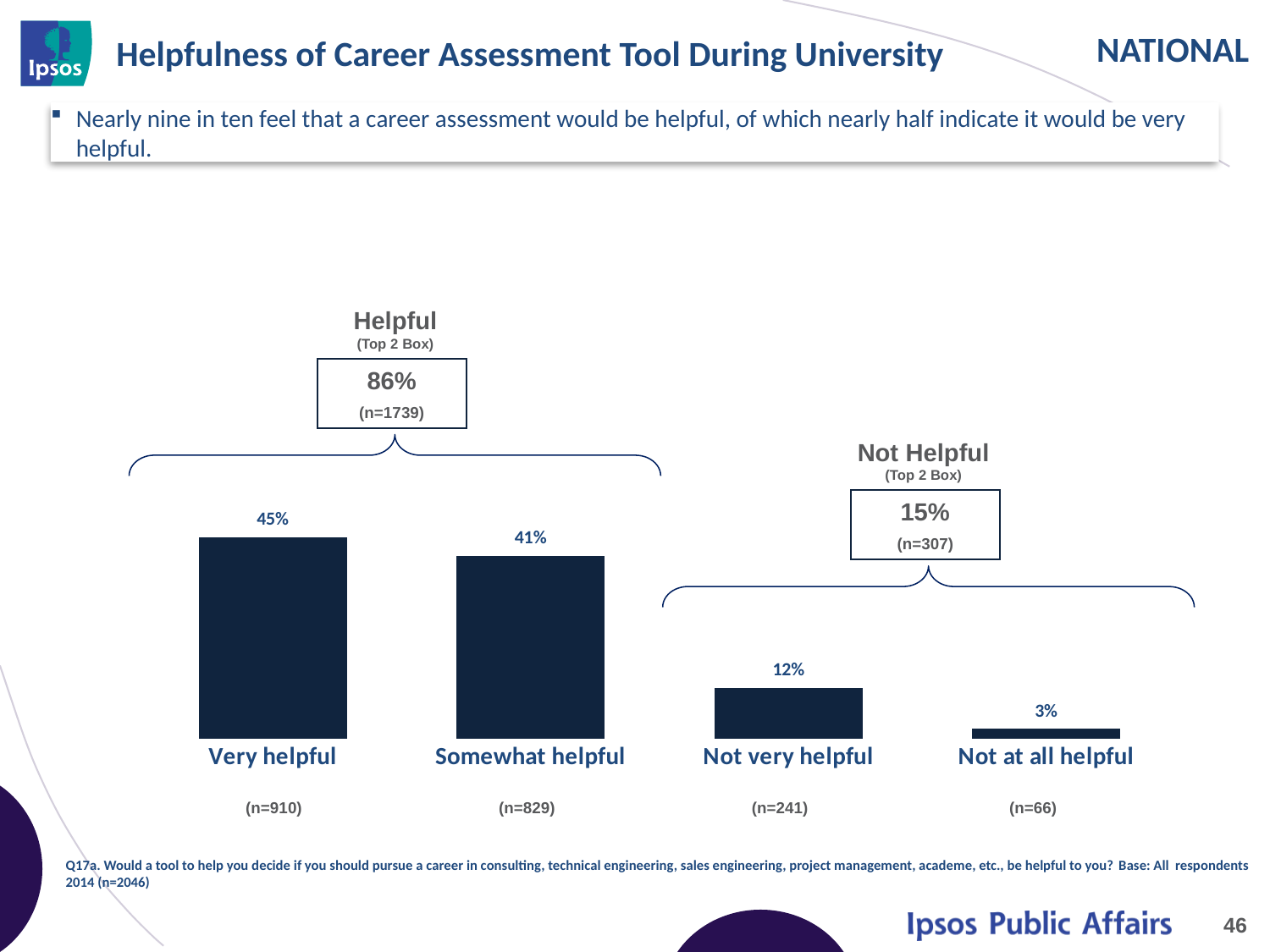
Which is larger, the percentage for 'Not very helpful' or 'Not at all helpful'? Not very helpful What type of chart is shown on the slide? Bar chart What is the Helpful (Top 2 Box) percentage shown on the slide? 86% Which response category has the highest percentage? Very helpful What is the difference in percentage points between 'Very helpful' and 'Somewhat helpful'? 4 Which response category has the lowest percentage? Not at all helpful What percentage of respondents said a career assessment tool would be very helpful? 45% What percentage of respondents said a career assessment tool would be not very helpful? 12% How many response categories are shown as bars in the chart? 4 What is the Not Helpful (Top 2 Box) percentage shown on the slide? 15% What percentage of respondents said a career assessment tool would be not at all helpful? 3% What percentage of respondents said a career assessment tool would be somewhat helpful? 41%